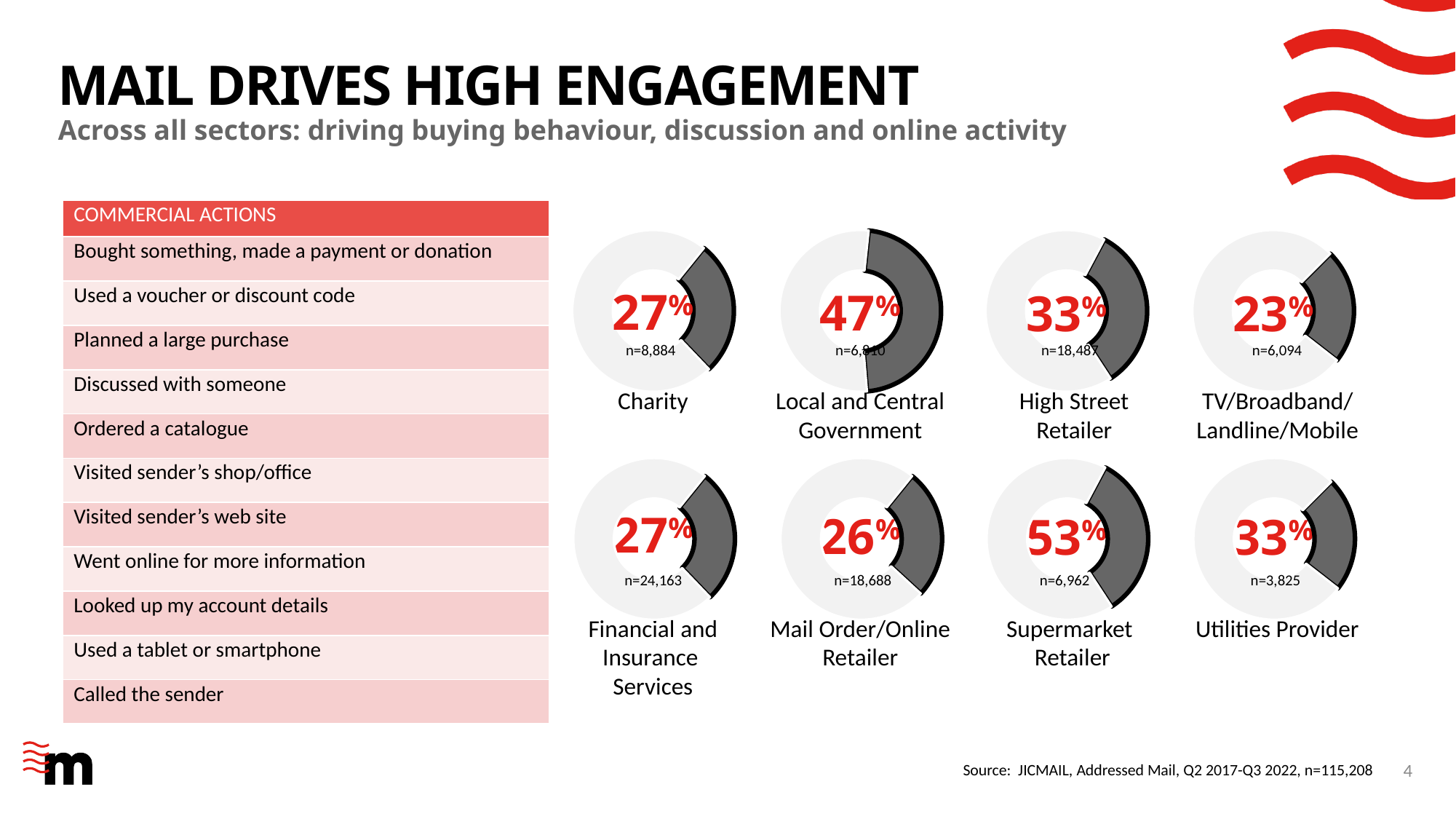
What type of chart is used to show the percentage for each sector? Donut chart In the Supermarket Retailer donut chart, what percentage is shown? 53% Across the eight donut charts, which sector shows the lowest percentage? TV/Broadband/Landline/Mobile In the Charity donut chart, what percentage is shown? 27% In the TV/Broadband/Landline/Mobile donut chart, what percentage is shown? 23% In the Utilities Provider donut chart, what percentage is shown? 33% Across the eight donut charts, which sector shows the highest percentage? Supermarket Retailer Which is larger: the percentage in the Local and Central Government donut chart or the percentage in the High Street Retailer donut chart? Local and Central Government How many donut charts are shown on the slide? 8 In the Mail Order/Online Retailer donut chart, what sample size (n) is shown? n=18,688 What is the difference between the percentage in the Supermarket Retailer donut chart and the percentage in the Charity donut chart? 26 percentage points In the Financial and Insurance Services donut chart, what sample size (n) is shown? n=24,163